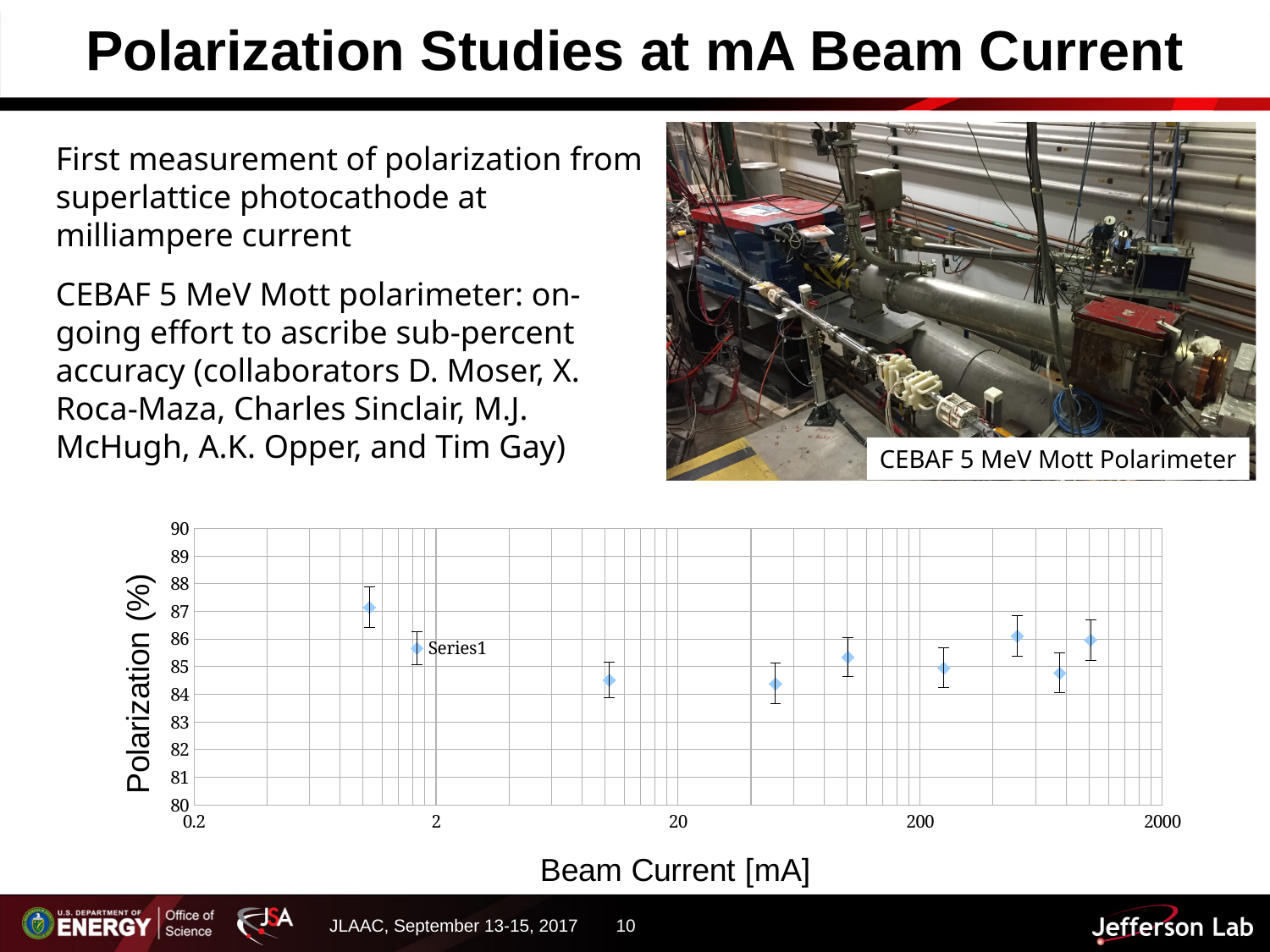
Which data point has the highest polarization value? The leftmost point (near 1 mA) What is the label of the x axis of the chart? Beam Current [mA] Is the polarization value of the data point near 40 mA greater or less than 85? less What is the maximum value shown on the y axis of the chart? 90 Do the polarization values rise or fall from the first data point to the third data point along the x axis? fall How many data points are plotted in the chart? 9 How many series are plotted in the chart? 1 Is the polarization value of the data point near 10 mA greater or less than 85? less Is the polarization of the leftmost point (near 1 mA) larger or smaller than that of the point near 10 mA? larger Is the polarization value of the leftmost data point (near 1 mA) greater or less than 86? greater What kind of chart is shown at the bottom of the slide? Scatter chart What is the label of the y axis of the chart? Polarization (%)